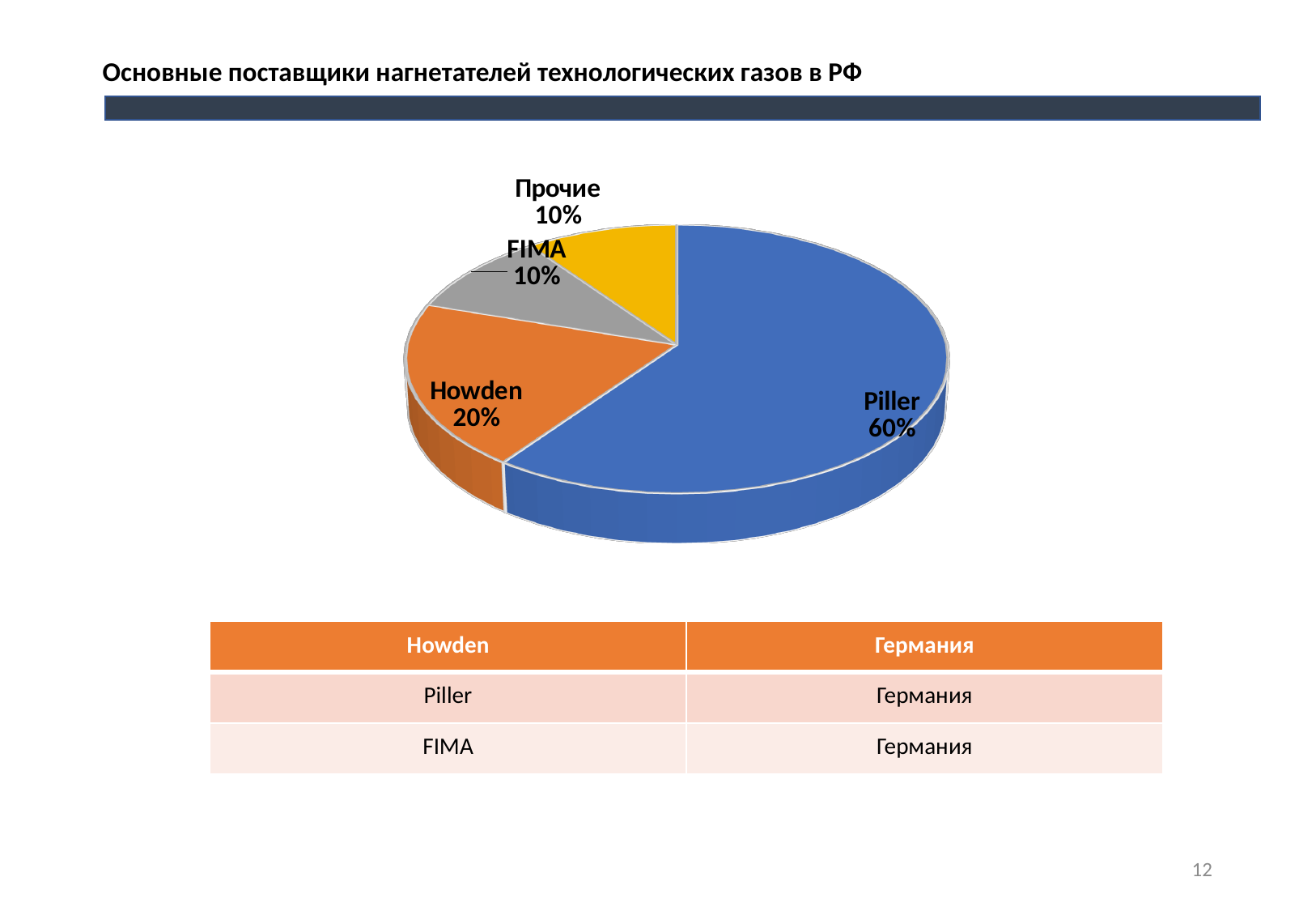
What is the difference between the shares of Piller and Howden? 40% What share of the pie does Piller hold? 60% What kind of chart is shown on the slide? Pie chart Which supplier has the largest slice of the pie? Piller What is the difference between the shares of Howden and FIMA? 10% How many slices does the pie chart have? 4 What is the value shown for Howden? 20% What is the value shown for Прочие? 10% What colour is the Piller slice? Blue What is the title of the slide above the chart? Основные поставщики нагнетателей технологических газов в РФ Which is larger, the share of Howden or the share of FIMA? Howden What is the value shown for FIMA? 10%